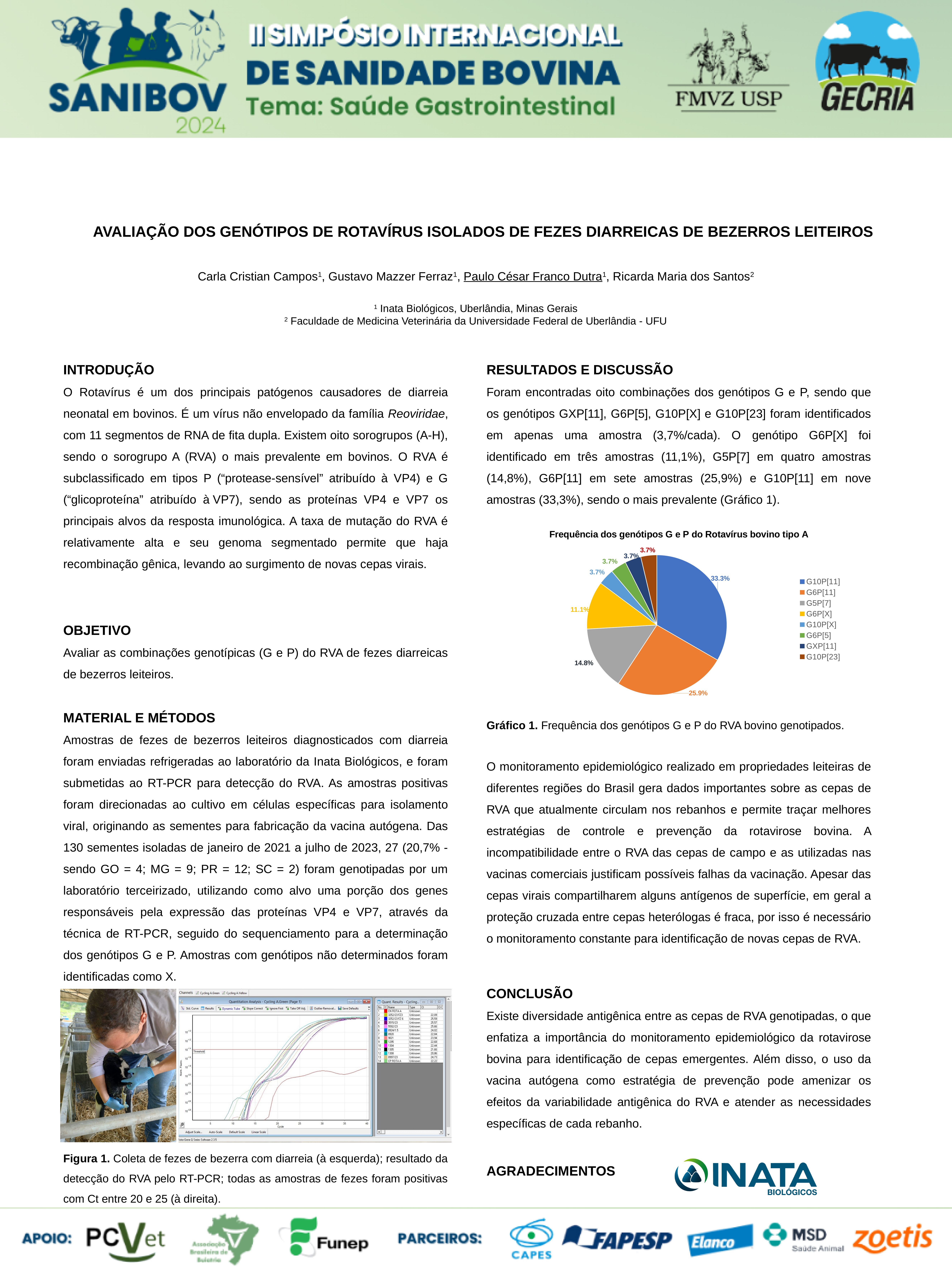
How many genotype categories does the pie chart legend list? 8 What share of the pie does G6P[X] represent? 11.1% Which slice is larger, G5P[7] or G6P[X]? G5P[7] What share of the pie does G5P[7] represent? 14.8% Which genotype has the largest slice of the pie? G10P[11] What share of the pie does G10P[11] represent? 33.3% What share of the pie does G6P[11] represent? 25.9% What type of chart is shown on the slide? pie chart What is the difference in percentage points between the G10P[11] slice and the G6P[11] slice? 7.4 What colour is the G10P[11] slice in the pie chart? blue What is the title of the chart? Frequência dos genótipos G e P do Rotavírus bovino tipo A What percentage is shown for the G10P[23] slice? 3.7%